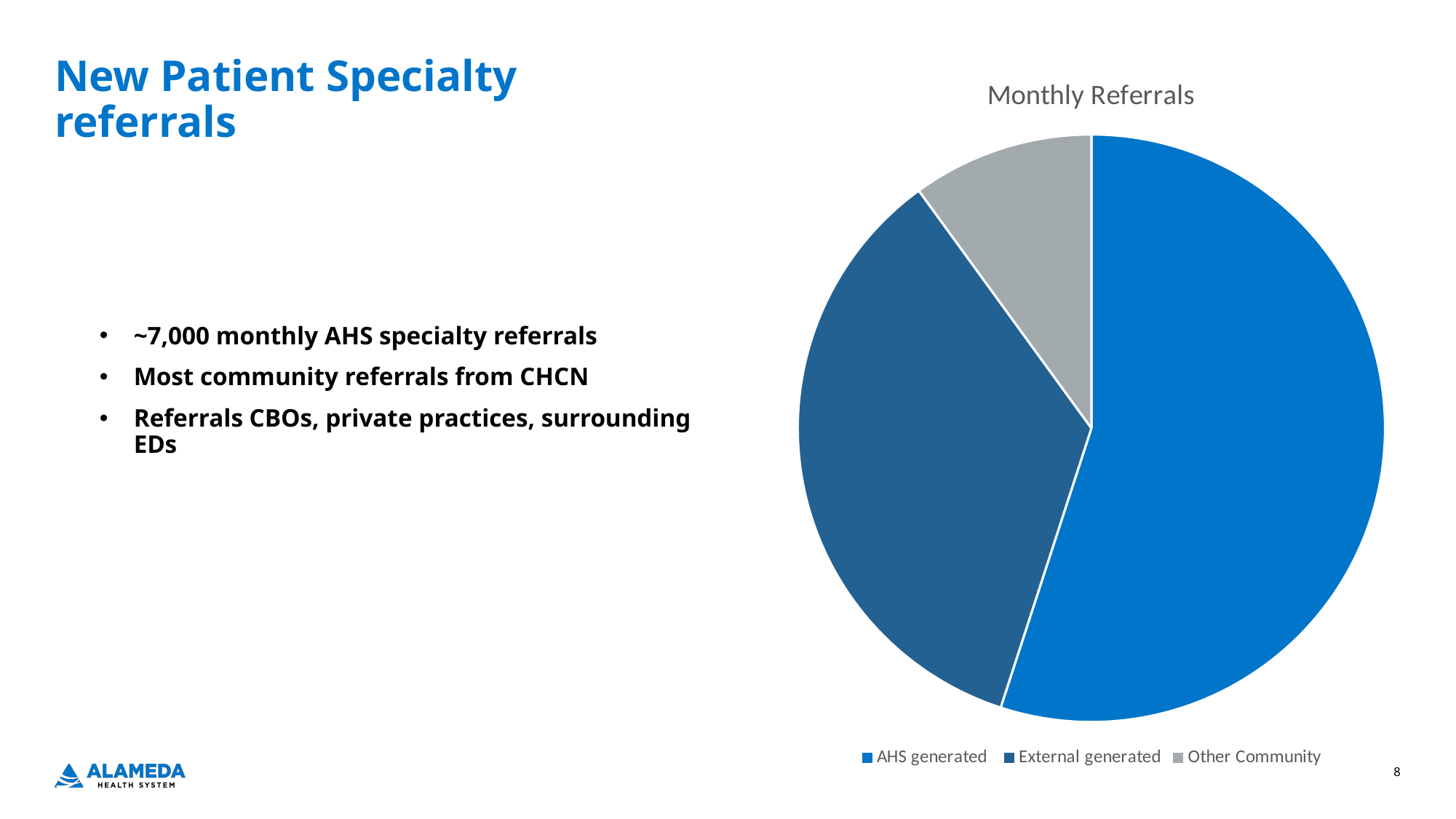
What is the title of the chart? Monthly Referrals What kind of chart is shown on the slide? Pie chart Which category has the smallest slice of the pie? Other Community Which slice is larger: External generated or Other Community? External generated How many entries does the chart legend list? 3 Does the AHS generated slice make up more or less than half of the pie? More Which slice is larger: AHS generated or External generated? AHS generated Which category has the largest slice of the pie? AHS generated Which category is shown in grey in the pie chart? Other Community How many slices does the pie chart have? 3